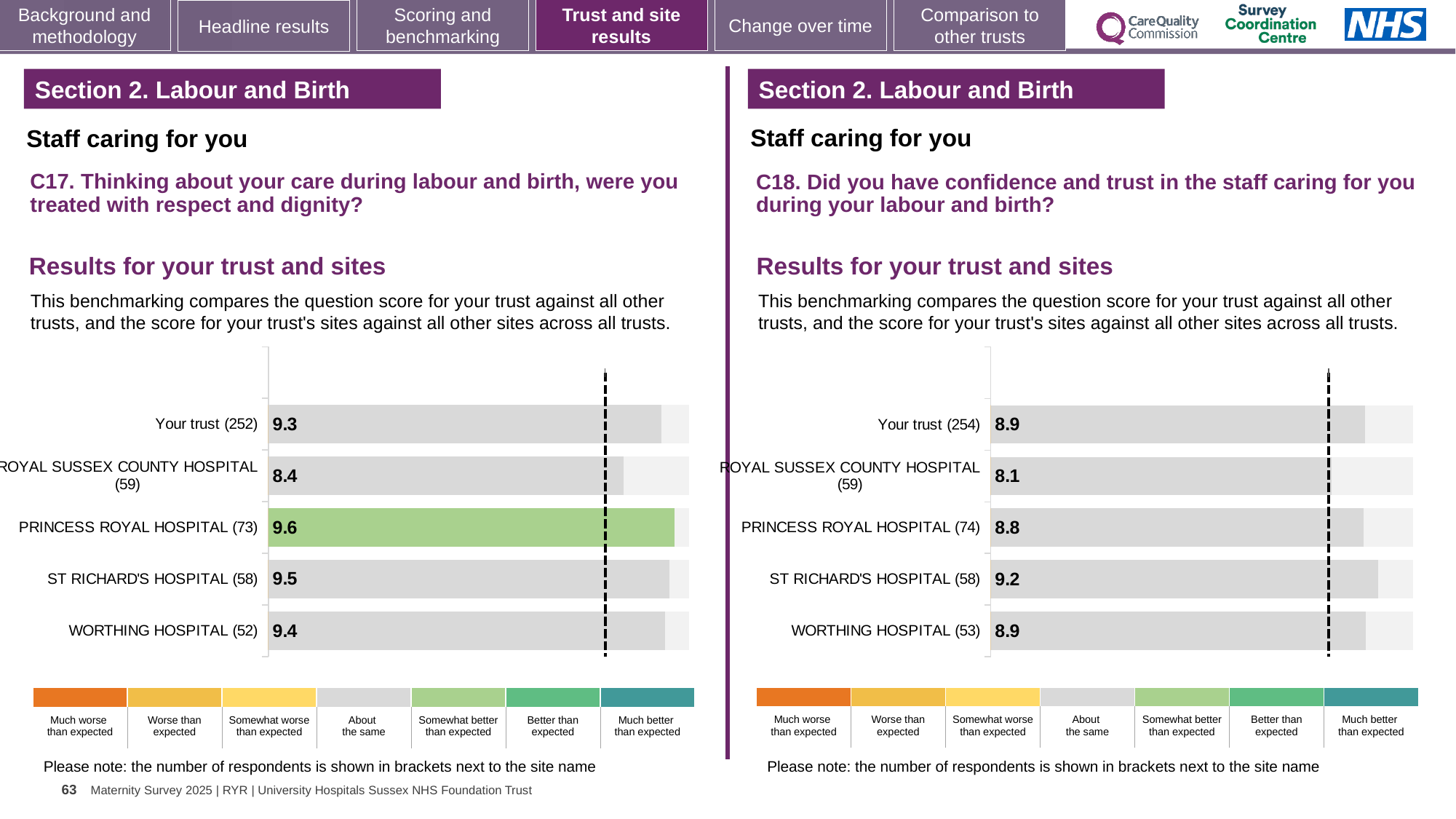
What type of chart is used on the left to show the C17 results? Bar chart In the C17 chart on the left, which site's bar is coloured green, indicating 'Somewhat better than expected'? PRINCESS ROYAL HOSPITAL In the C18 chart on the right, what is the difference between the scores for St Richard's Hospital and Your trust? 0.3 In the C18 chart on the right, which has the larger score: Princess Royal Hospital or Worthing Hospital? WORTHING HOSPITAL In the C17 chart on the left, which site has the lowest score? ROYAL SUSSEX COUNTY HOSPITAL In the C18 chart on the right, what is the score for St Richard's Hospital? 9.2 In the C18 chart on the right, which site has the highest score? ST RICHARD'S HOSPITAL In the C17 chart on the left, how many bars are plotted? 5 In the C18 chart on the right, which site has the lowest score? ROYAL SUSSEX COUNTY HOSPITAL In the C17 chart on the left, what is the difference between the scores for Princess Royal Hospital and Royal Sussex County Hospital? 1.2 In the C17 chart on the left, what is the score for Your trust? 9.3 In the C17 chart on the left, which site has the highest score? PRINCESS ROYAL HOSPITAL